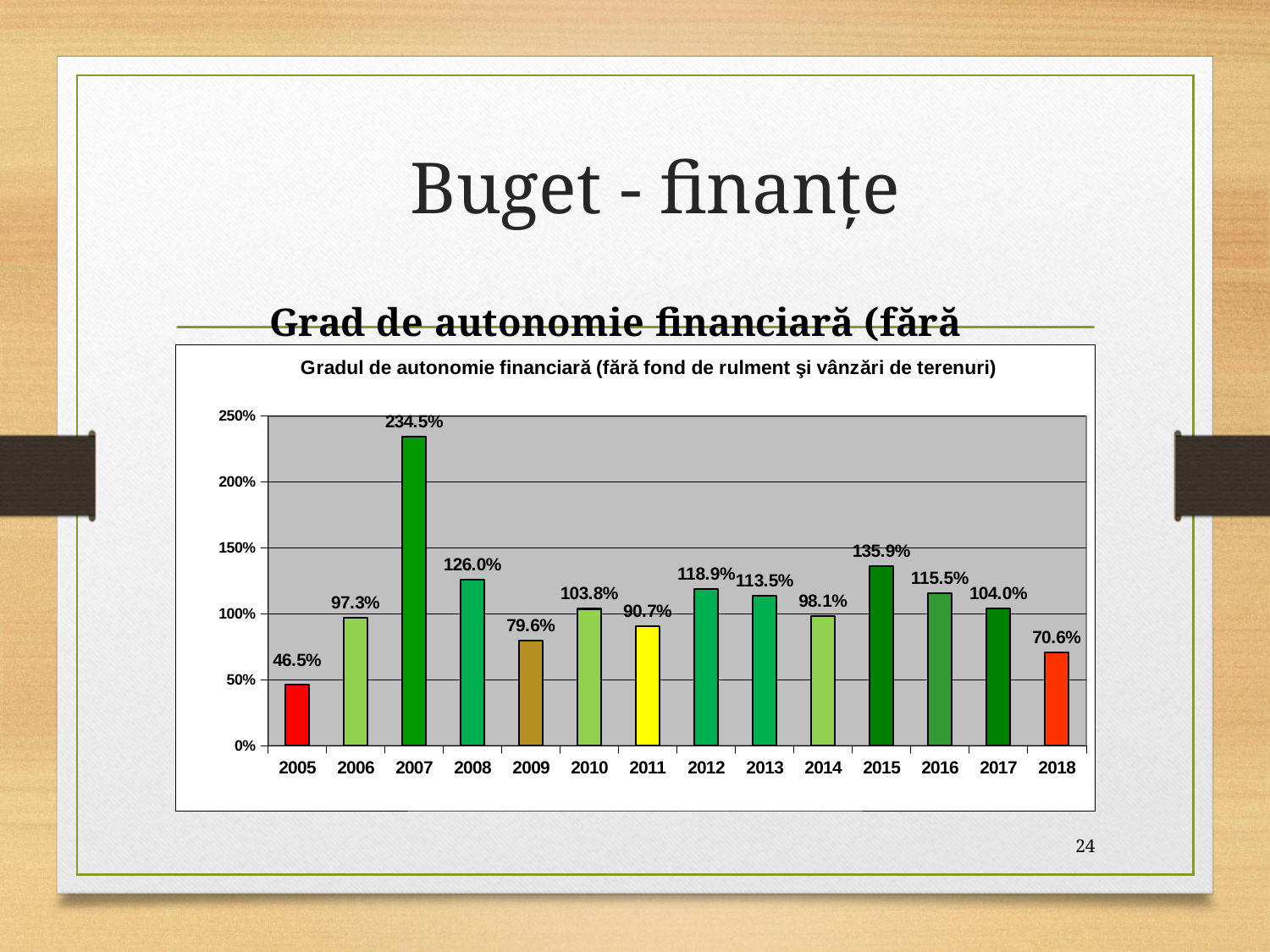
How many years are shown on the x axis? 14 Which is larger, the value for 2012 or the value for 2013? 2012 Is the value for 2009 greater or less than 100%? less Which year has the highest value? 2007 Do the values rise or fall from 2015 to 2018? fall Which year has the lowest value? 2005 What is the value for 2011? 90.7% What is the value for 2018? 70.6% What is the value for 2007? 234.5% What kind of chart is shown? bar chart What is the title of the chart? Gradul de autonomie financiară (fără fond de rulment şi vânzări de terenuri) What is the difference between the values for 2015 and 2016? 20.4%